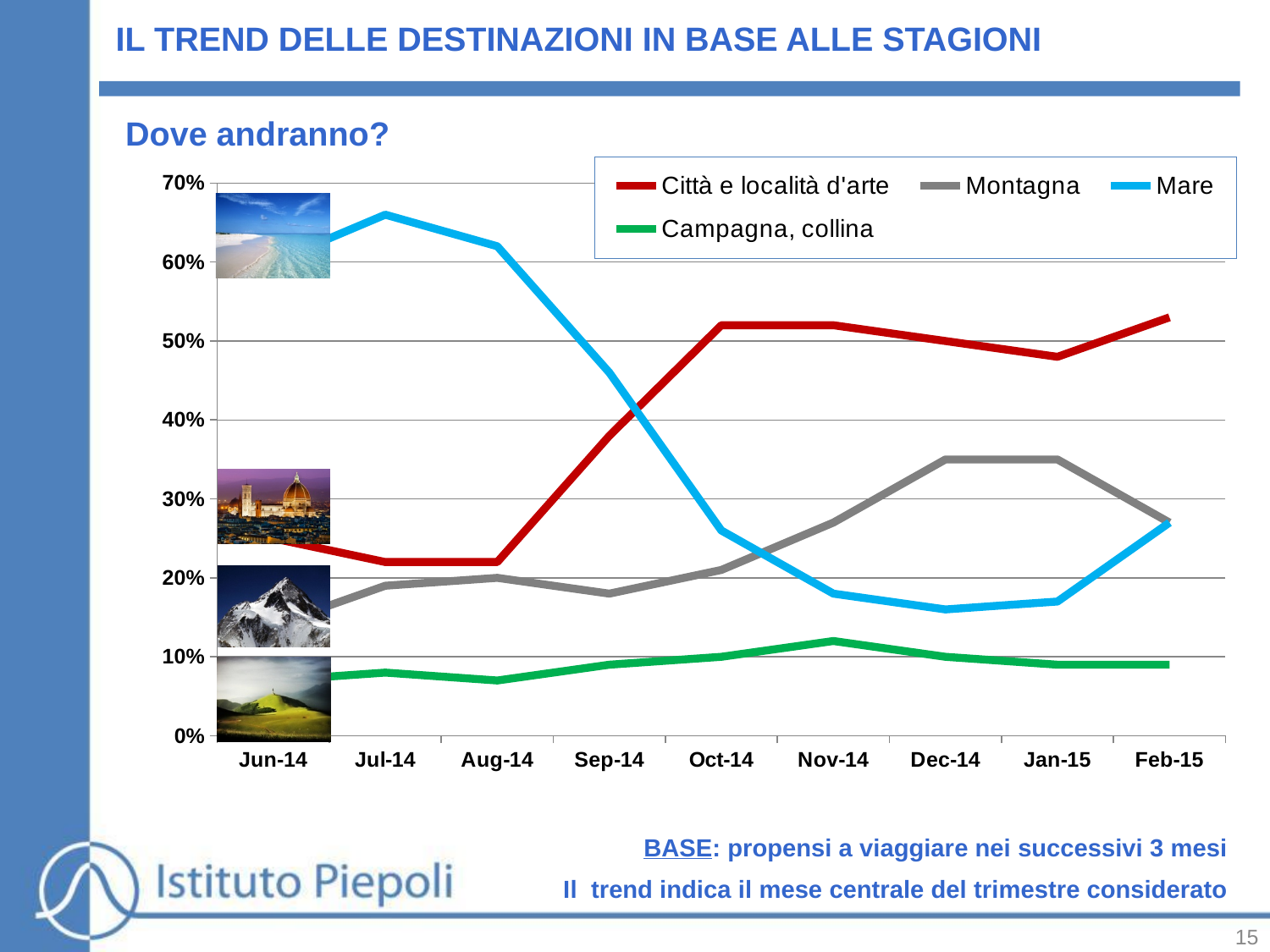
Does the Mare series rise or fall from Jul-14 to Dec-14? fall Is the value for Città e località d'arte in Jun-14 greater or less than 30%? less Is the value for Montagna in Dec-14 greater or less than 30%? greater What kind of chart is shown on the slide? line chart Which series has the highest value in Jul-14? Mare How many series does the legend list? 4 In Nov-14, which is larger: Montagna or Mare? Montagna How many months are shown along the x axis? 9 Which series has the lowest value in Feb-15? Campagna, collina Which series has the highest value in Dec-14? Città e località d'arte Is the value for Mare in Jul-14 greater or less than 60%? greater Does the Città e località d'arte series rise or fall from Aug-14 to Oct-14? rise